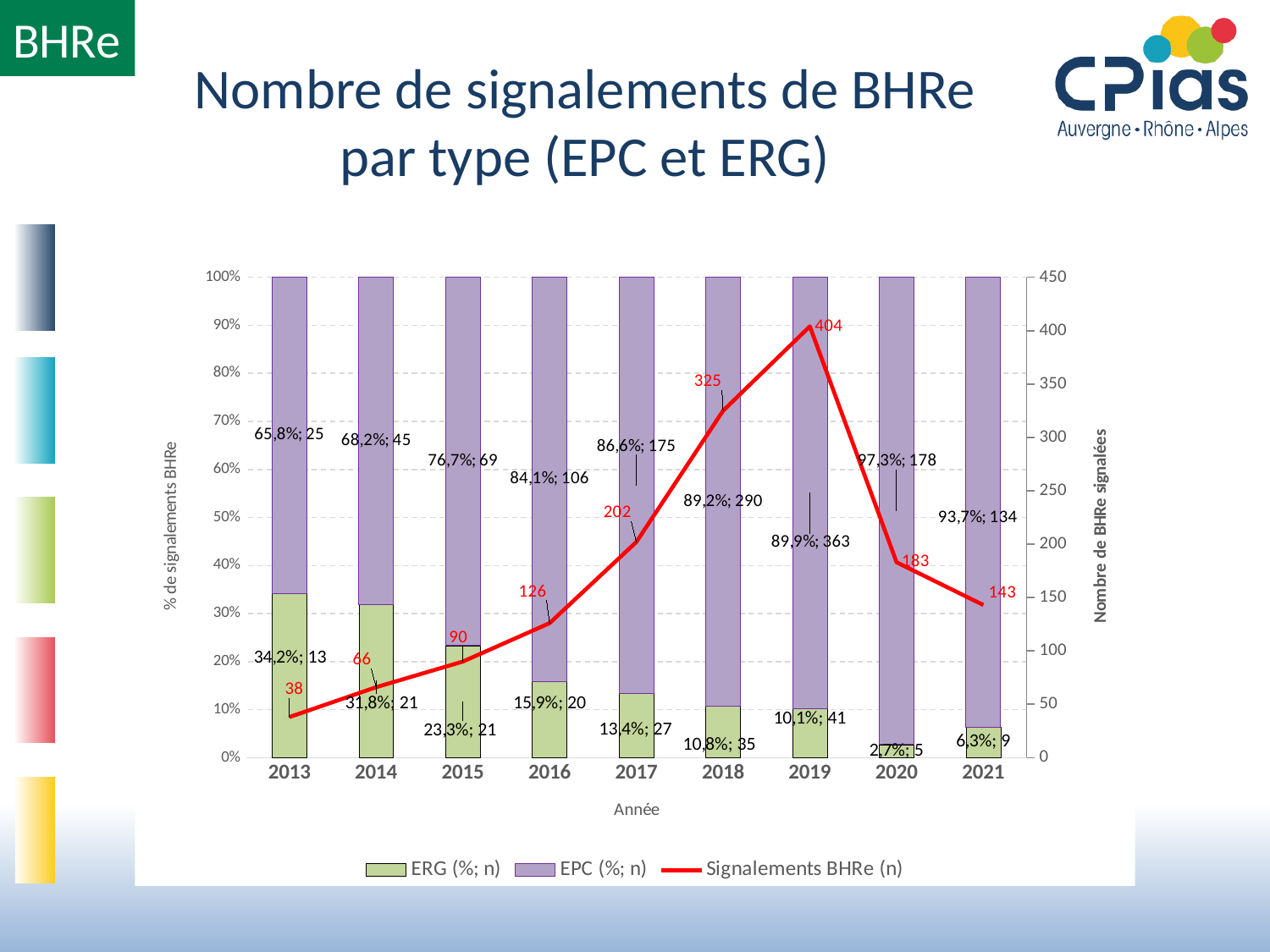
What is the value of Signalements BHRe (n) for 2013? 38 What is the data label for EPC (%; n) in 2018? 89,2%; 290 What is the label of the right-hand vertical axis? Nombre de BHRe signalées What is the difference in Signalements BHRe (n) between 2019 and 2020? 221 How many years are shown on the x axis? 9 Which year has a larger number of Signalements BHRe (n), 2017 or 2021? 2017 What is the data label for ERG (%; n) in 2020? 2,7%; 5 What is the value of Signalements BHRe (n) for 2019? 404 How many series does the legend list? 3 In which year is the number of Signalements BHRe (n) highest? 2019 In which year is the number of Signalements BHRe (n) lowest? 2013 Does the number of Signalements BHRe (n) rise or fall from 2013 to 2019? rise